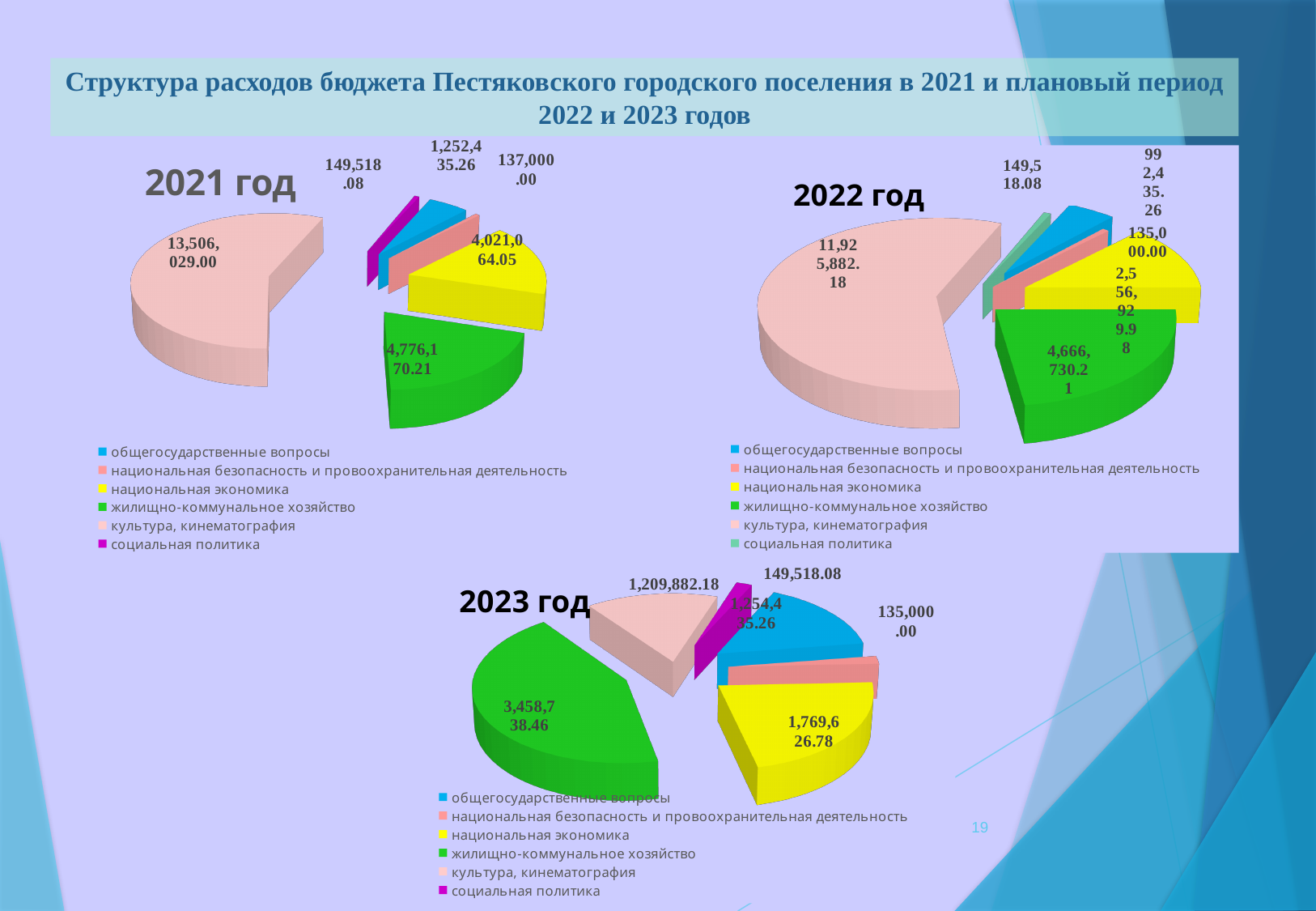
In the 2022 год chart, what is the value for культура, кинематография? 11,925,882.18 In the 2023 год chart, what is the value for национальная экономика? 1,769,626.78 In the 2023 год chart, which category has the largest slice? жилищно-коммунальное хозяйство In the 2022 год chart, what is the value for национальная экономика? 2,556,929.98 In the 2021 год chart, what is the difference between жилищно-коммунальное хозяйство and национальная экономика? 755,106.16 What kind of chart is used for the 2021 год data? pie chart In the 2021 год chart, what is the value for жилищно-коммунальное хозяйство? 4,776,170.21 In the 2021 год chart, which category has the smallest value? национальная безопасность и провоохранительная деятельность In the 2022 год chart, which is larger: жилищно-коммунальное хозяйство or национальная экономика? жилищно-коммунальное хозяйство In the 2021 год chart, which category has the largest slice? культура, кинематография How many categories does the legend of the 2021 год chart list? 6 In the 2021 год chart, what is the value for культура, кинематография? 13,506,029.00